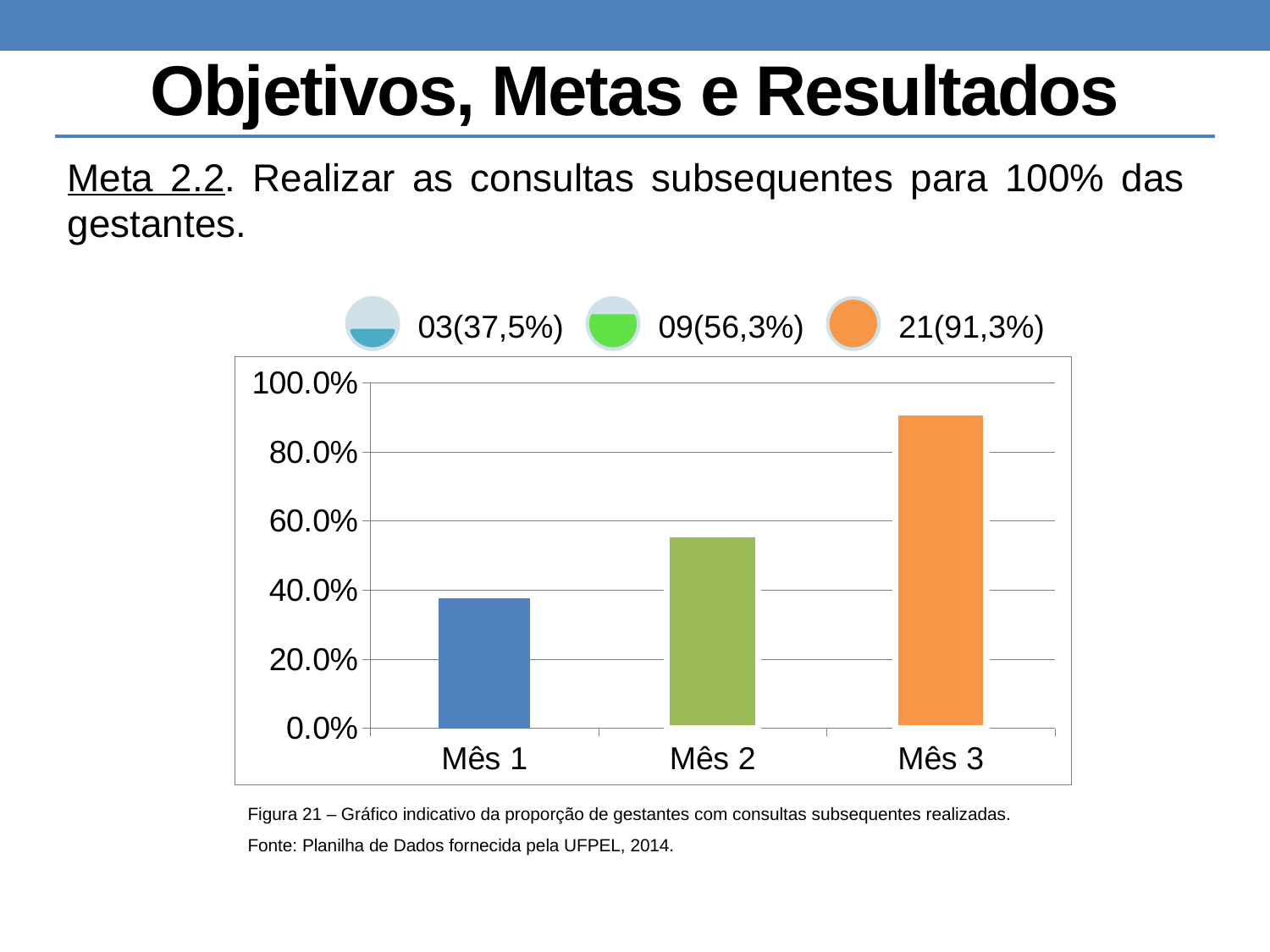
What kind of chart is shown on the slide? bar chart According to the labels above the chart, what percentage corresponds to the blue bar (Mês 1)? 37,5% Is the value for Mês 2 greater or less than 40.0%? greater According to the labels above the chart, what percentage corresponds to the green bar (Mês 2)? 56,3% How many categories are plotted on the x axis of the chart? 3 Is the value for Mês 3 greater or less than 80.0%? greater Do the values rise or fall from Mês 1 to Mês 3? rise Which month has the lowest bar in the chart? Mês 1 Which month has the highest bar in the chart? Mês 3 What is the figure number given in the caption below the chart? Figura 21 How many gestantes does the label for the orange bar (Mês 3) indicate? 21 According to the labels above the chart, what percentage corresponds to the orange bar (Mês 3)? 91,3%